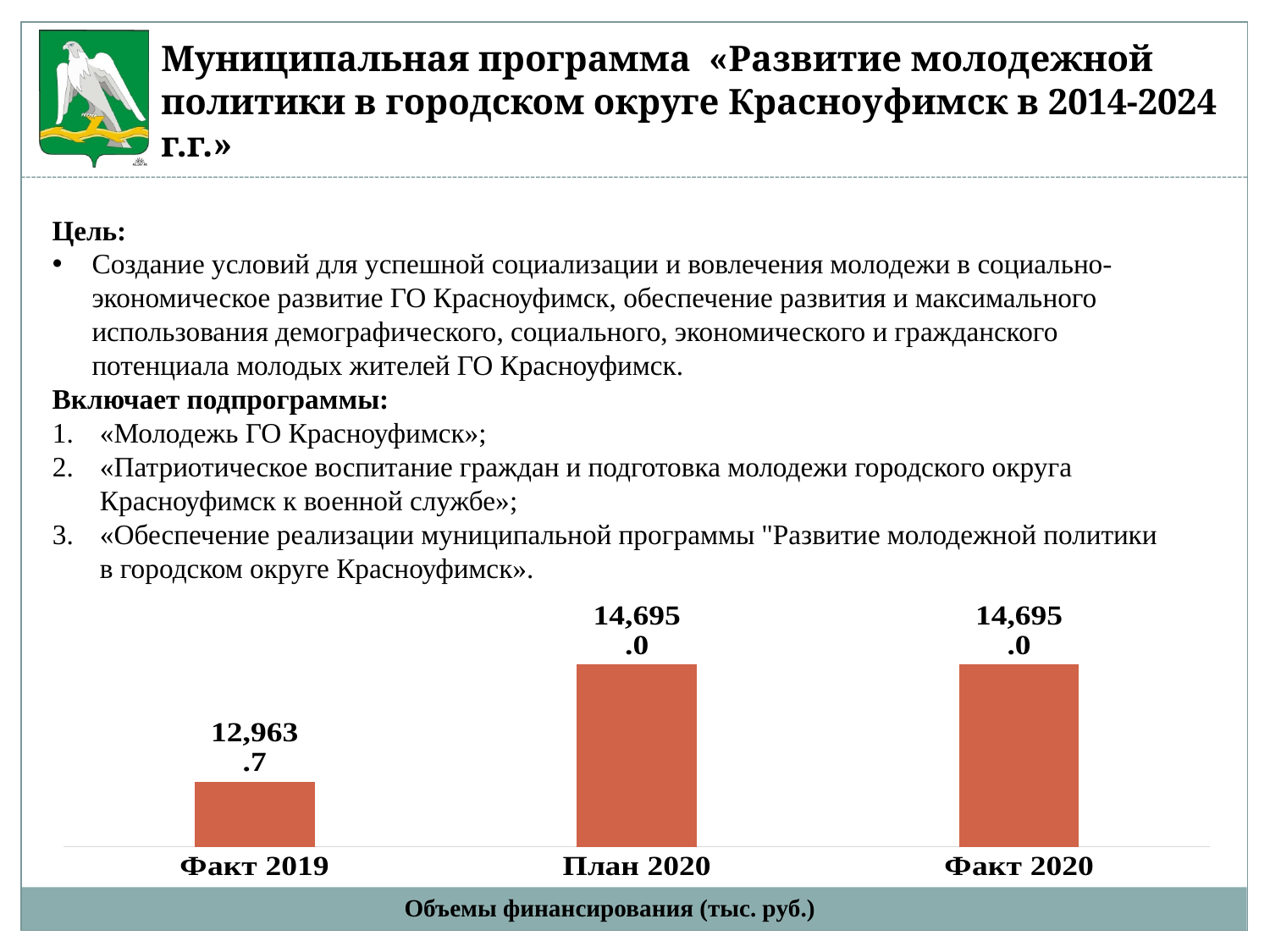
Does the value rise or fall from Факт 2019 to План 2020? Rise What is the title of the chart? Объемы финансирования (тыс. руб.) What kind of chart is shown on the slide? Bar chart What is the difference between the values for План 2020 and Факт 2019? 1,731.3 What is the value for Факт 2020 in the chart? 14,695.0 What is the value for Факт 2019 in the chart? 12,963.7 Which category has the lowest value in the chart? Факт 2019 Which is larger, the value for Факт 2019 or the value for Факт 2020? Факт 2020 How many categories are shown in the chart? 3 Are the values for План 2020 and Факт 2020 equal? Yes What colour are the bars in the chart? Orange-red What is the value for План 2020 in the chart? 14,695.0